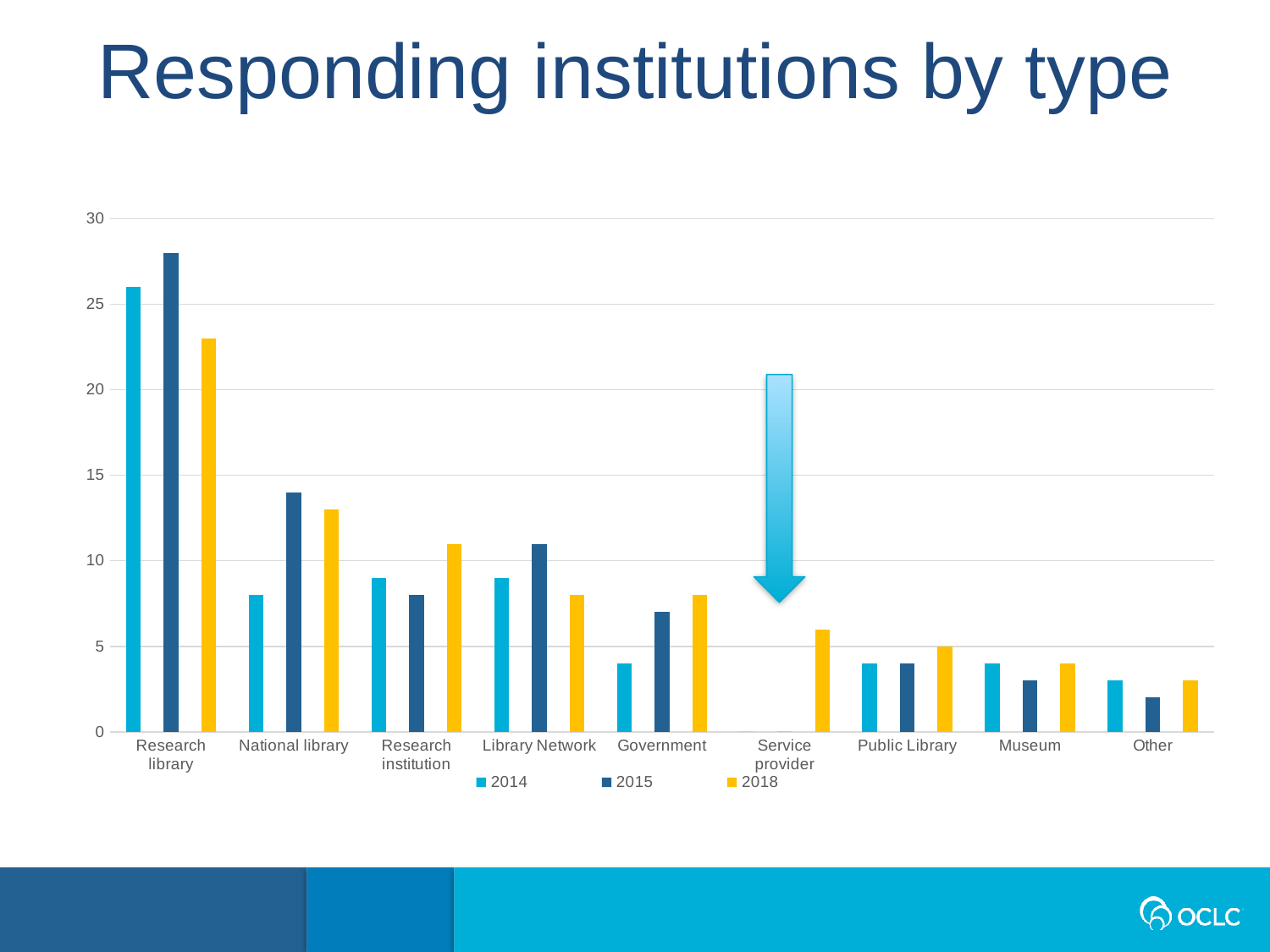
What is the 2018 value for Public Library? 5 What is the title of the chart? Responding institutions by type Which is larger for National library, the 2014 value or the 2015 value? 2015 Is the 2015 value for Research library greater or less than 25? greater How many institution types are shown on the x axis? 9 Which institution type has the highest bar in the chart? Research library Is the 2018 value for National library greater or less than 10? greater How many series does the legend list? 3 What kind of chart is shown on the slide? bar chart Which years have a bar for Service provider? 2018 only Is the 2014 value for Government greater or less than 5? less Which year has the highest value for Research library? 2015